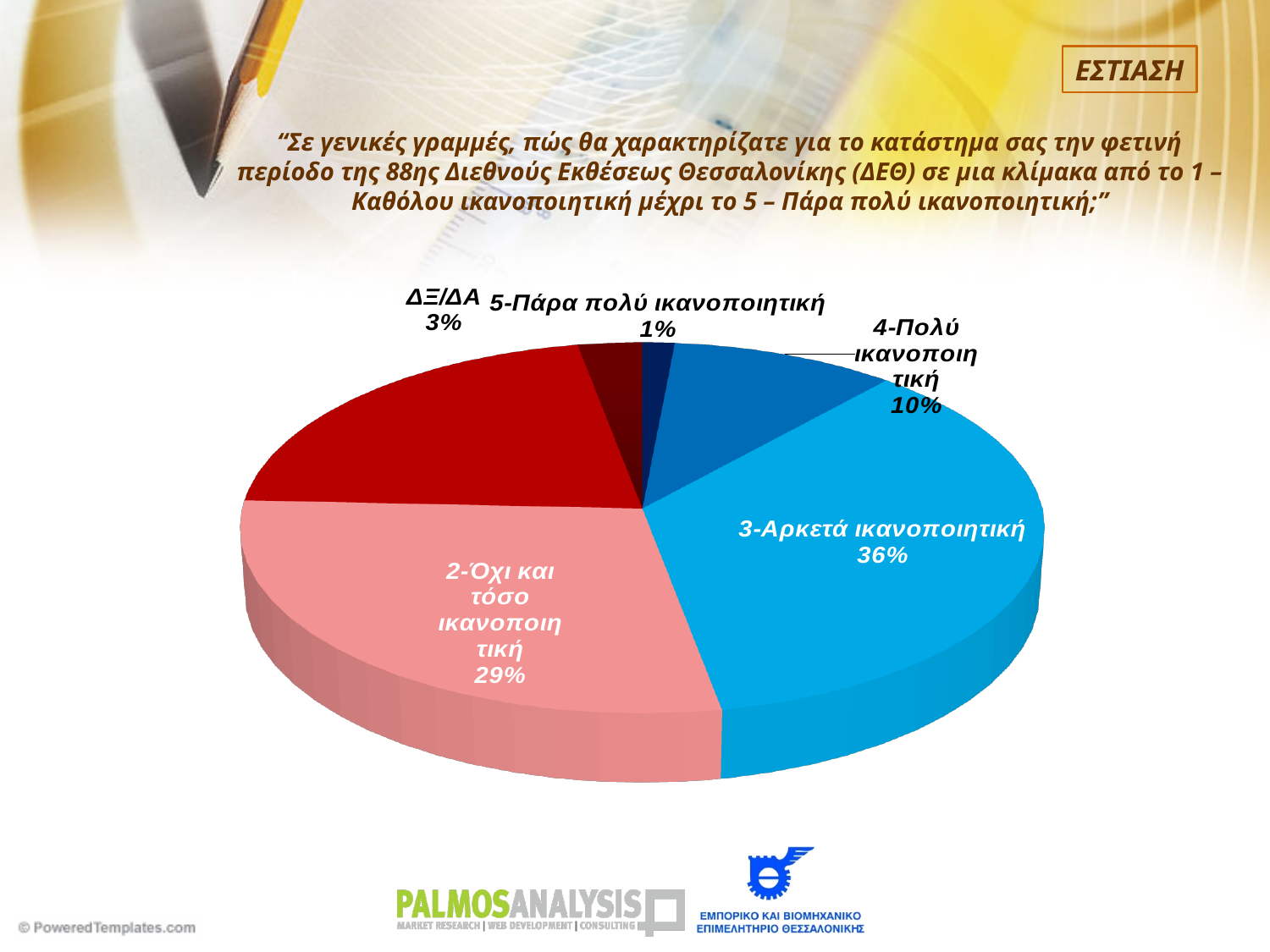
Which labelled category has the largest share of the pie? 3-Αρκετά ικανοποιητική Which is larger, the share for "4-Πολύ ικανοποιητική" or the share for "ΔΞ/ΔΑ"? 4-Πολύ ικανοποιητική What percentage is shown for "2-Όχι και τόσο ικανοποιητική"? 29% What percentage is shown for "5-Πάρα πολύ ικανοποιητική"? 1% What percentage is shown for "ΔΞ/ΔΑ"? 3% What is the combined share of "4-Πολύ ικανοποιητική" and "5-Πάρα πολύ ικανοποιητική"? 11% What kind of chart is shown on the slide? pie chart What percentage of the pie is labelled "3-Αρκετά ικανοποιητική"? 36% What percentage is shown for "4-Πολύ ικανοποιητική"? 10% How many slices does the pie chart have? 6 What is the difference in percentage points between "3-Αρκετά ικανοποιητική" and "2-Όχι και τόσο ικανοποιητική"? 7 Which labelled category has the smallest share of the pie? 5-Πάρα πολύ ικανοποιητική